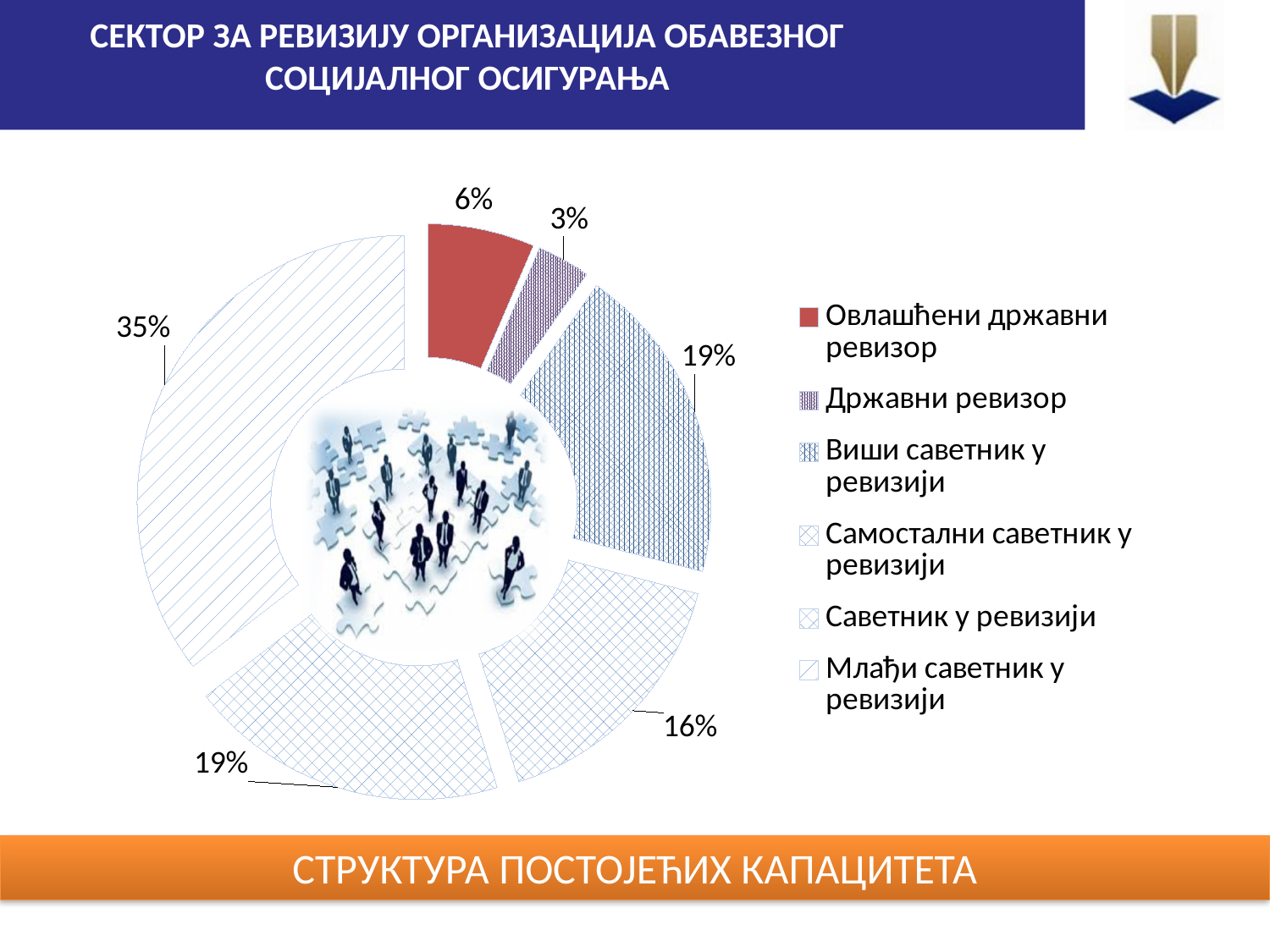
What percentage is shown for Самостални саветник у ревизији? 16% Which category has the smallest share of the chart? Државни ревизор Which category is shown in solid red? Овлашћени државни ревизор How many categories does the legend list? 6 What percentage is shown for Млађи саветник у ревизији? 35% What is the difference in percentage points between Млађи саветник у ревизији and Самостални саветник у ревизији? 19 What percentage is shown for Овлашћени државни ревизор? 6% Which category has the largest share of the chart? Млађи саветник у ревизији What percentage is shown for Виши саветник у ревизији? 19% What kind of chart is shown on the slide? doughnut (pie) chart What percentage is shown for Државни ревизор? 3% Which is larger, the share for Овлашћени државни ревизор or the share for Државни ревизор? Овлашћени државни ревизор